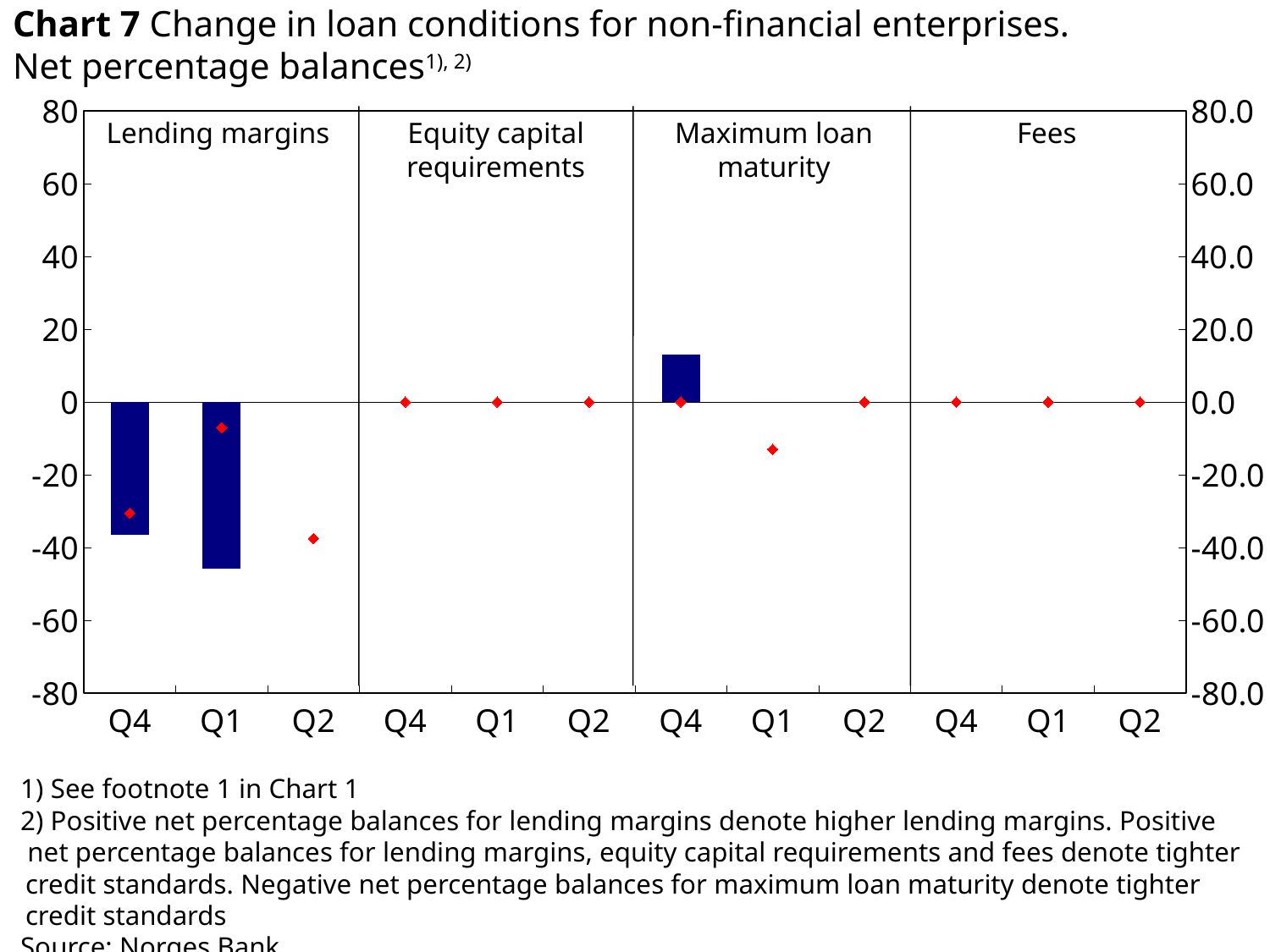
Which panel has the highest bar value in the chart? Maximum loan maturity Is the bar value for Maximum loan maturity in Q4 greater or less than 0? greater What is the maximum value shown on the left vertical axis? 80 How many quarters are shown on the x axis within each panel? 3 Is the bar value for Lending margins in Q4 greater or less than -20? less What kind of chart is shown on the slide? bar chart Which panel has the lowest bar value in the chart? Lending margins How many panels (loan condition categories) does the chart have? 4 Within the Lending margins panel, which bar is lower, Q4 or Q1? Q1 Is the bar value for Lending margins in Q1 greater or less than -40? less